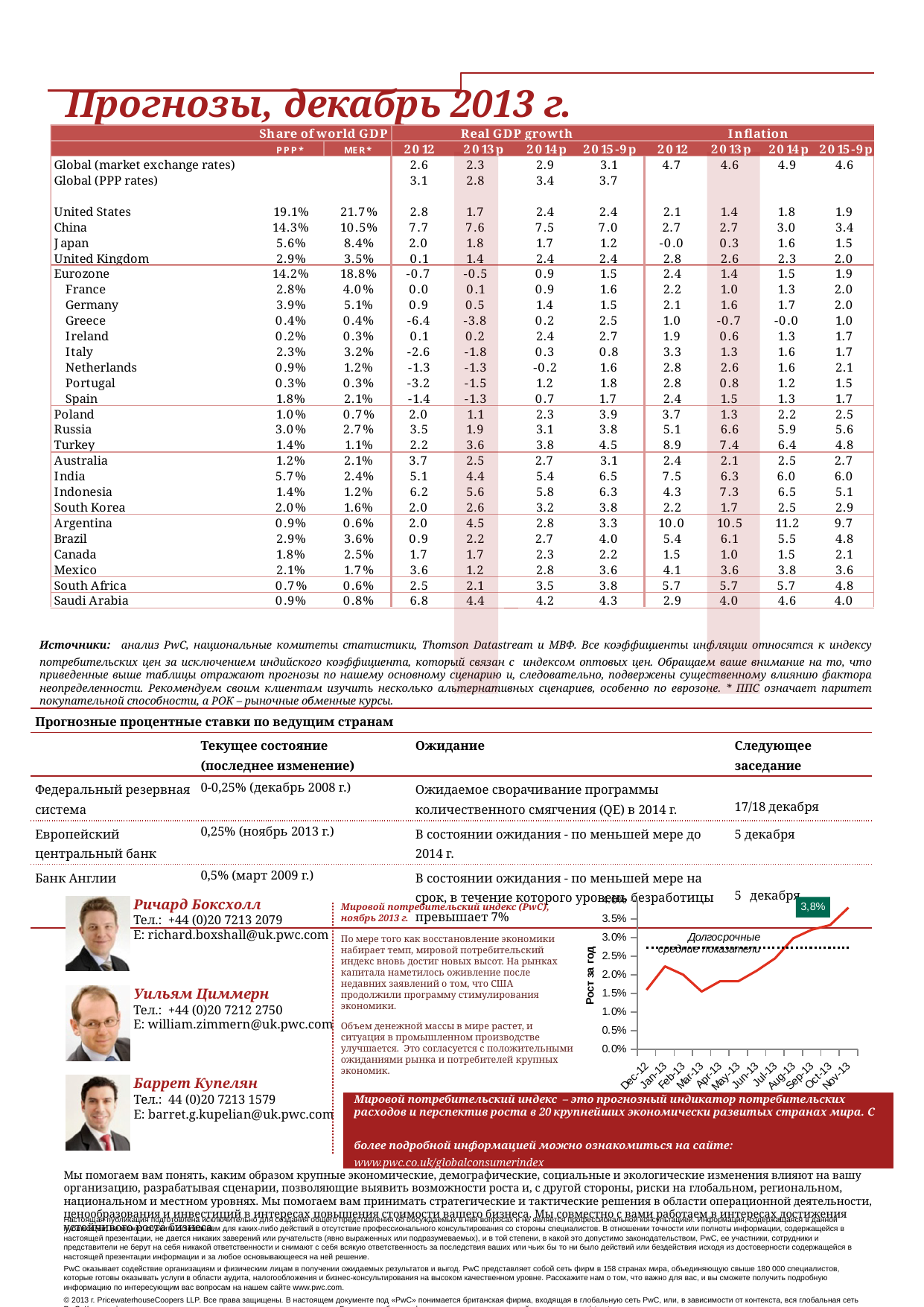
In the line chart 'Мировой потребительский индекс (PwC), ноябрь 2013 г.', is the value for Oct-13 greater or less than 3.0%? greater In the line chart 'Мировой потребительский индекс (PwC), ноябрь 2013 г.', how many monthly points are plotted along the x axis? 12 In the line chart 'Мировой потребительский индекс (PwC), ноябрь 2013 г.', what is the label on the y axis? Рост за год In the line chart 'Мировой потребительский индекс (PwC), ноябрь 2013 г.', do the values generally rise or fall from Dec-12 to Nov-13? rise In the line chart 'Мировой потребительский индекс (PwC), ноябрь 2013 г.', what value is labelled for Nov-13? 3,8% In the line chart 'Мировой потребительский индекс (PwC), ноябрь 2013 г.', what does the dotted horizontal line represent? Долгосрочные средние показатели In the line chart 'Мировой потребительский индекс (PwC), ноябрь 2013 г.', is the value for Dec-12 greater or less than 2.0%? less In the line chart 'Мировой потребительский индекс (PwC), ноябрь 2013 г.', is the value for Mar-13 greater or less than 2.0%? less In the line chart 'Мировой потребительский индекс (PwC), ноябрь 2013 г.', which is larger, the value for Nov-13 or the value for Dec-12? Nov-13 What kind of chart is shown at the bottom right of the slide (Мировой потребительский индекс)? line chart In the line chart 'Мировой потребительский индекс (PwC), ноябрь 2013 г.', which month has the highest value? Nov-13